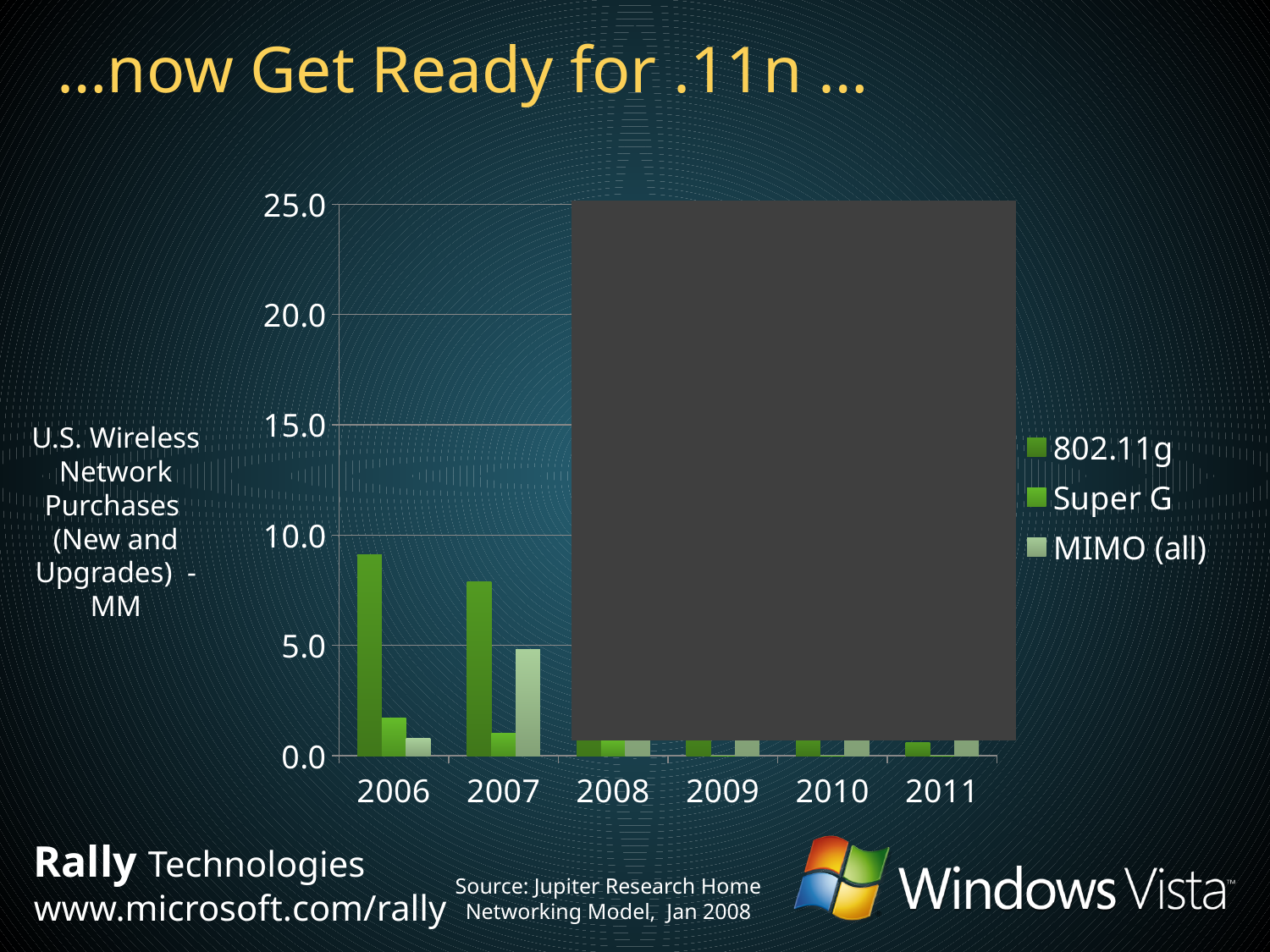
How many series does the legend list? 3 Which series are listed in the legend? 802.11g, Super G, MIMO (all) Is the value for Super G in 2006 greater or less than 5.0? less Is the value for 802.11g in 2006 greater or less than 5.0? greater Which is larger in 2006, the 802.11g bar or the Super G bar? 802.11g Which is larger in 2007, the MIMO (all) bar or the Super G bar? MIMO (all) What kind of chart is shown on the slide? bar chart Does the 802.11g value rise or fall from 2006 to 2007? fall Is the value for 802.11g in 2007 greater or less than 5.0? greater How many years are shown on the x axis? 6 What is the label on the vertical axis of the chart? U.S. Wireless Network Purchases (New and Upgrades) - MM